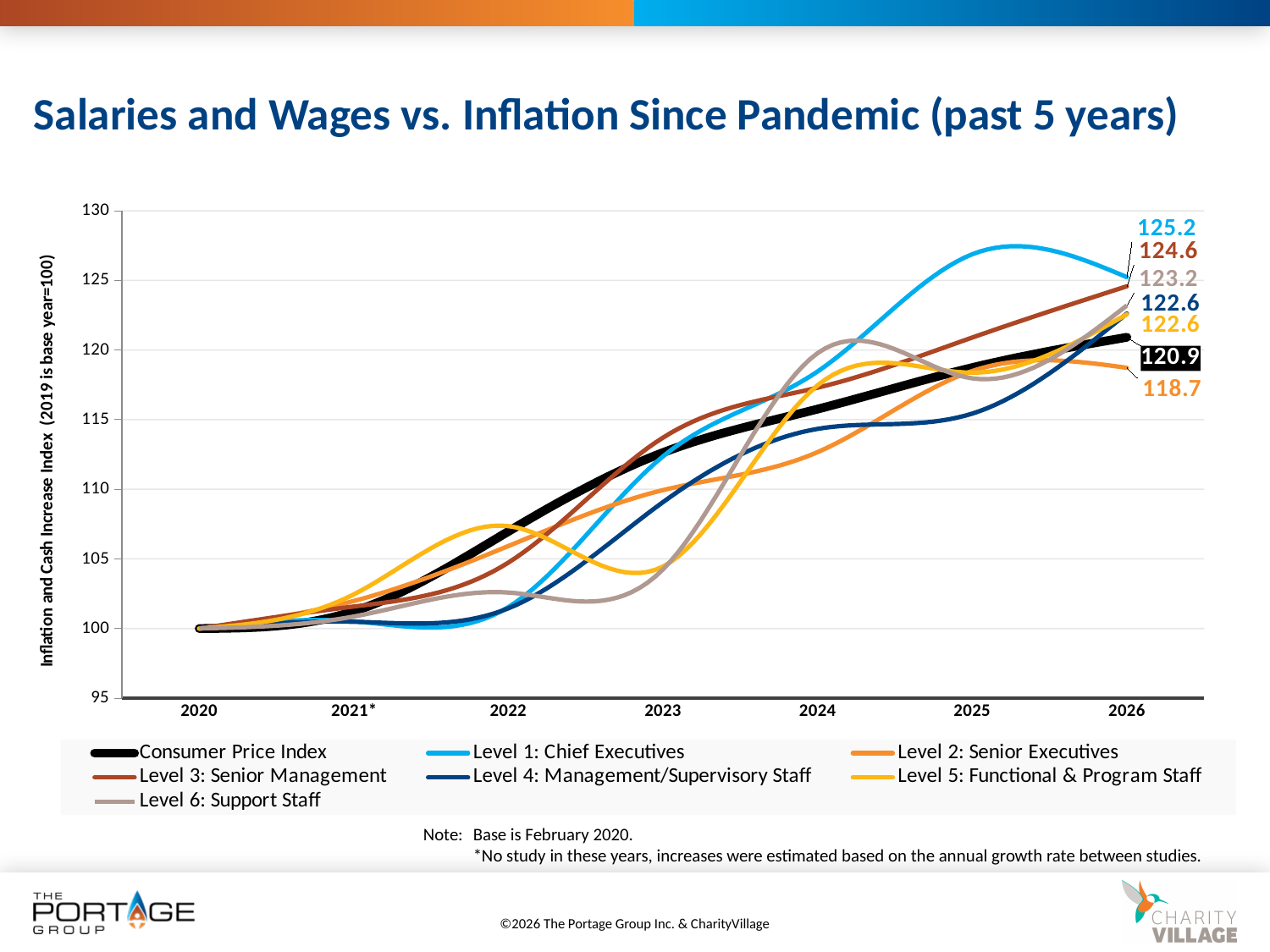
What is the difference between the 2026 values for Level 1: Chief Executives and the Consumer Price Index? 4.3 What kind of chart is shown on the slide? Line chart Which series has the lowest value in 2026? Level 2: Senior Executives Is the value for Level 5: Functional & Program Staff in 2022 greater or less than 105? greater In 2026, which is larger: Level 3: Senior Management or Level 6: Support Staff? Level 3: Senior Management Which series has the highest value in 2026? Level 1: Chief Executives What is the 2026 value for Level 1: Chief Executives? 125.2 What is the 2026 value for Level 6: Support Staff? 123.2 How many series does the legend list? 7 What is the 2026 value for the Consumer Price Index? 120.9 What is the 2026 value for Level 2: Senior Executives? 118.7 Does the Consumer Price Index rise or fall from 2020 to 2026? Rise